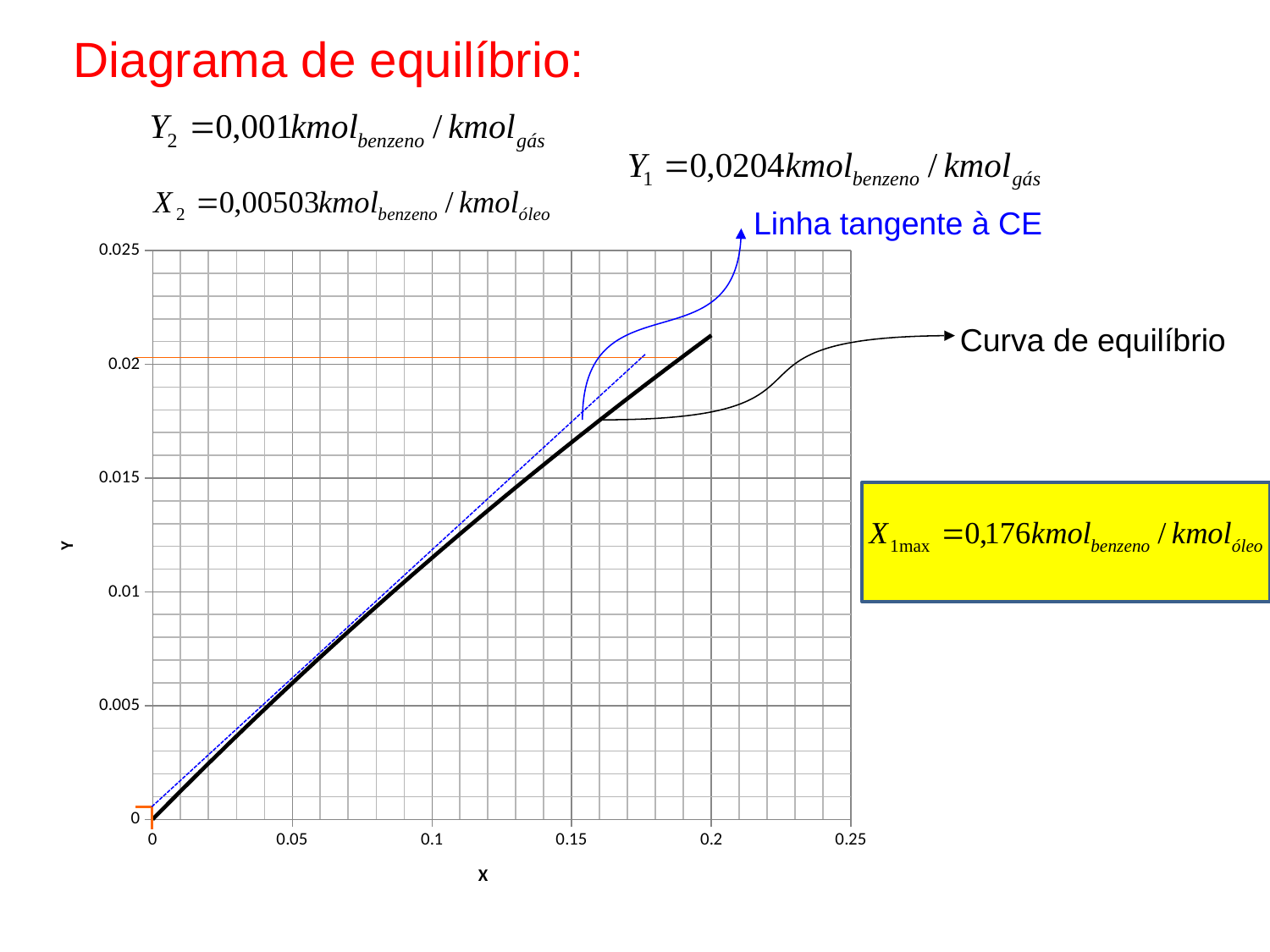
Is the value of Y on the equilibrium curve at X = 0.15 greater or less than 0.02? less What is the highest value shown on the x axis of the chart? 0.25 Is the value of Y on the equilibrium curve at X = 0.1 greater or less than 0.015? less Is the value of Y on the equilibrium curve at X = 0.2 greater or less than 0.015? greater What kind of chart is shown on the slide? line chart What is the highest value shown on the y axis of the chart? 0.025 Does the equilibrium curve (Curva de equilíbrio) rise or fall as X increases? rises How many labelled tick marks are there on the x axis of the chart? 6